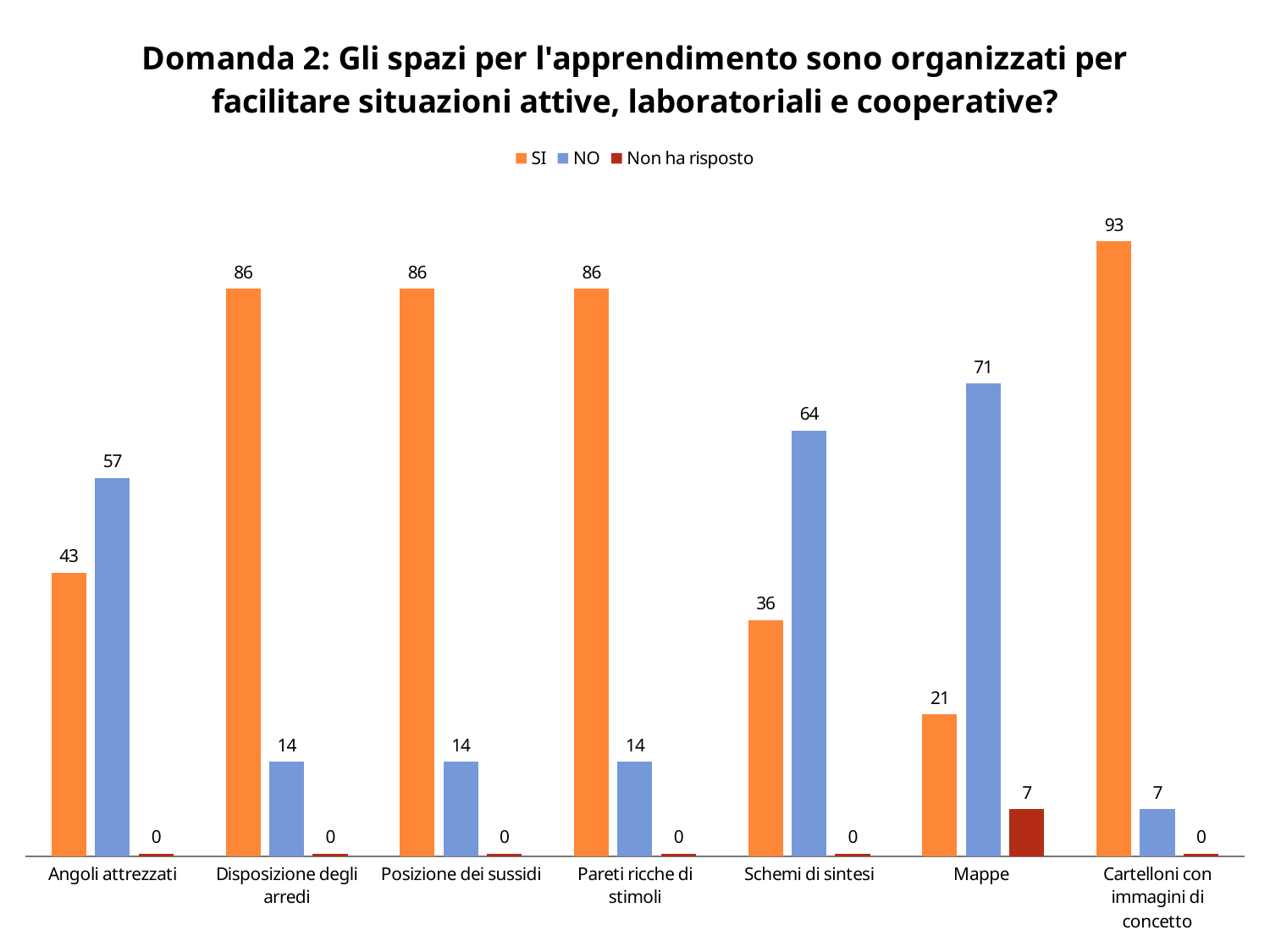
What is the Non ha risposto value for Mappe? 7 Which series is shown in orange in the legend? SI What is the difference between the SI and NO values for Schemi di sintesi? 28 Which category has the lowest SI value? Mappe What is the SI value for Angoli attrezzati? 43 What is the NO value for Mappe? 71 Which is larger for Angoli attrezzati, the SI value or the NO value? NO Which category has the highest SI value? Cartelloni con immagini di concetto How many series does the legend list? 3 What kind of chart is shown on the slide? Bar chart What is the NO value for Cartelloni con immagini di concetto? 7 How many categories are shown on the x axis? 7